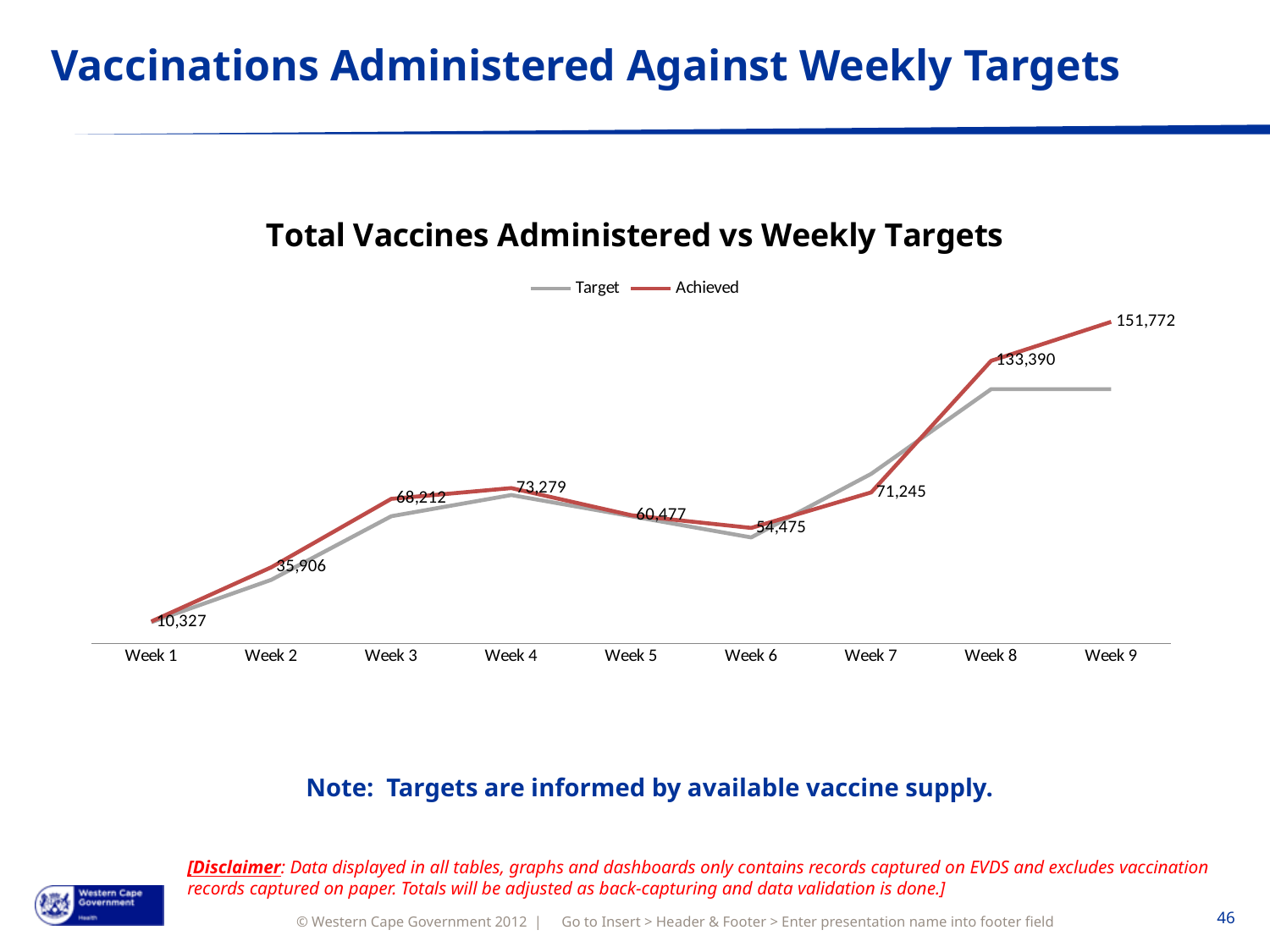
What is the Achieved value for Week 9? 151,772 Which week has the lowest Achieved value? Week 1 What is the Achieved value for Week 6? 54,475 What kind of chart is shown? Line chart Which week has the highest Achieved value? Week 9 How many series does the legend list? 2 What is the Achieved value for Week 1? 10,327 Which is larger, the Achieved value for Week 3 or for Week 7? Week 7 What is the difference between the Achieved values for Week 9 and Week 8? 18,382 How many weeks are shown on the x axis? 9 What is the Achieved value for Week 4? 73,279 Does the Achieved value rise or fall from Week 4 to Week 6? Fall